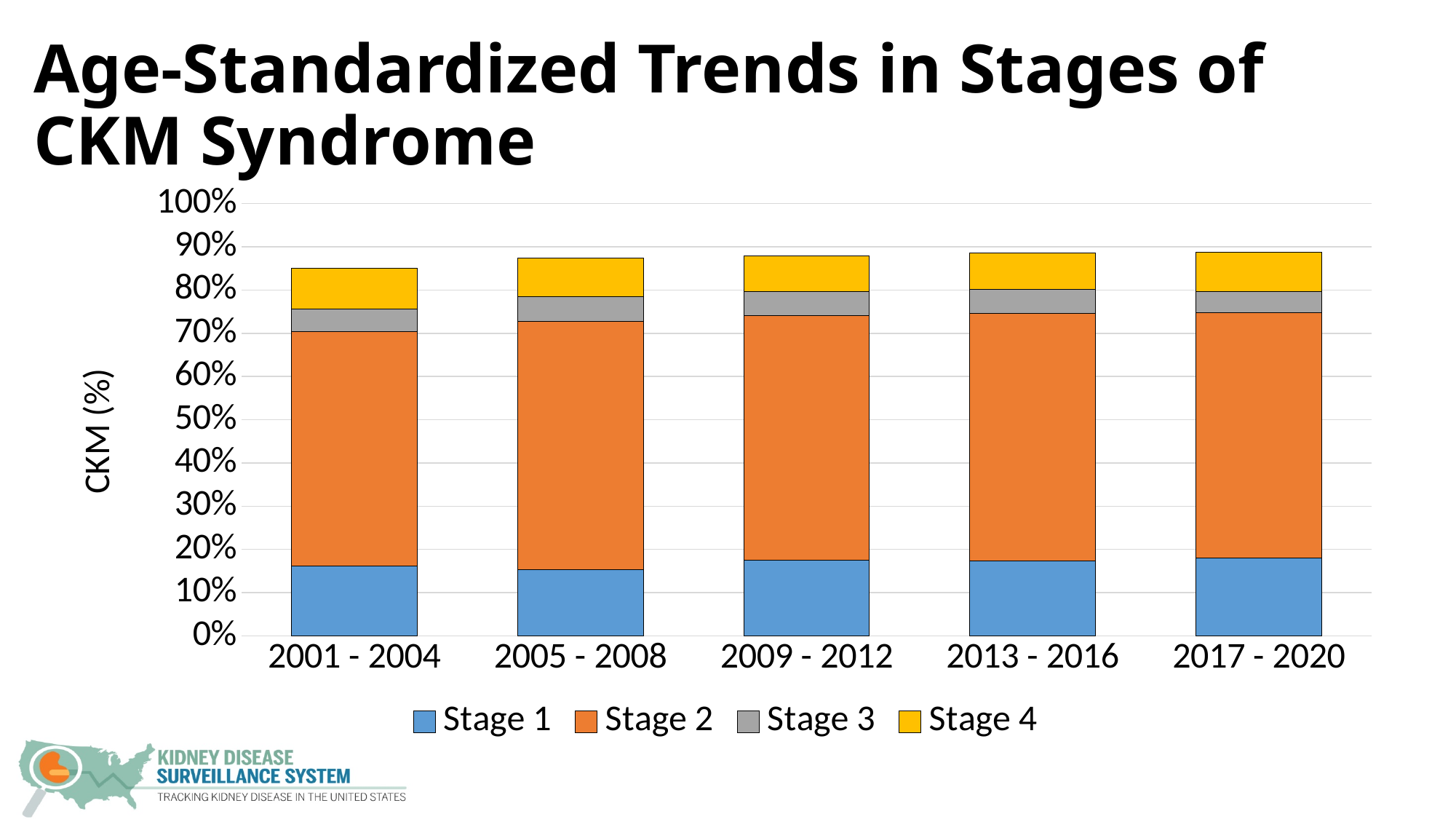
Is the value for Stage 1 in 2001 - 2004 greater or less than 20%? less How many series does the legend list? 4 Which stage makes up the largest segment of the bar for 2009 - 2012? Stage 2 What is the label on the y axis? CKM (%) Which time period has the lowest total stacked bar? 2001 - 2004 What is the title of the chart on the slide? Age-Standardized Trends in Stages of CKM Syndrome What kind of chart is shown on the slide? Stacked bar chart How many time periods are shown on the x axis? 5 Which is larger: the total stacked bar for 2001 - 2004 or for 2017 - 2020? 2017 - 2020 Is the total height of the stacked bar for 2001 - 2004 greater or less than 80%? greater Is the value for Stage 1 in 2017 - 2020 greater or less than 10%? greater